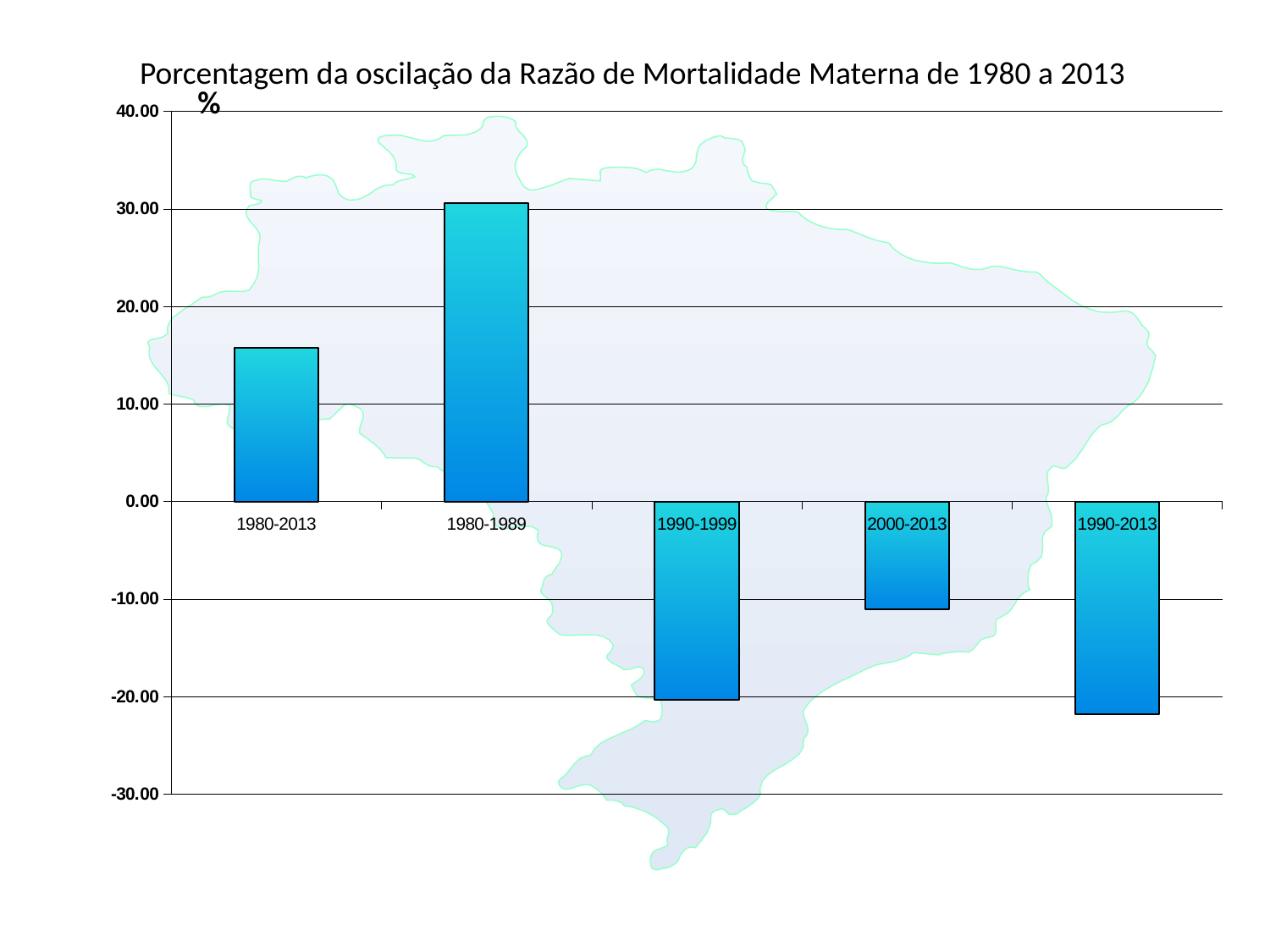
Which is larger, the value for 2000-2013 or the value for 1990-1999? 2000-2013 Is the value for 1990-1999 greater or less than -10.00? less What kind of chart is shown on the slide? bar chart Is the value for 1980-1989 greater or less than 20.00? greater Is the value for 1980-2013 greater or less than 10.00? greater How many periods (categories) are plotted on the chart? 5 Which period has the highest value on the chart? 1980-1989 What is the title of the chart? Porcentagem da oscilação da Razão de Mortalidade Materna de 1980 a 2013 Which is larger, the value for 1980-2013 or the value for 1980-1989? 1980-1989